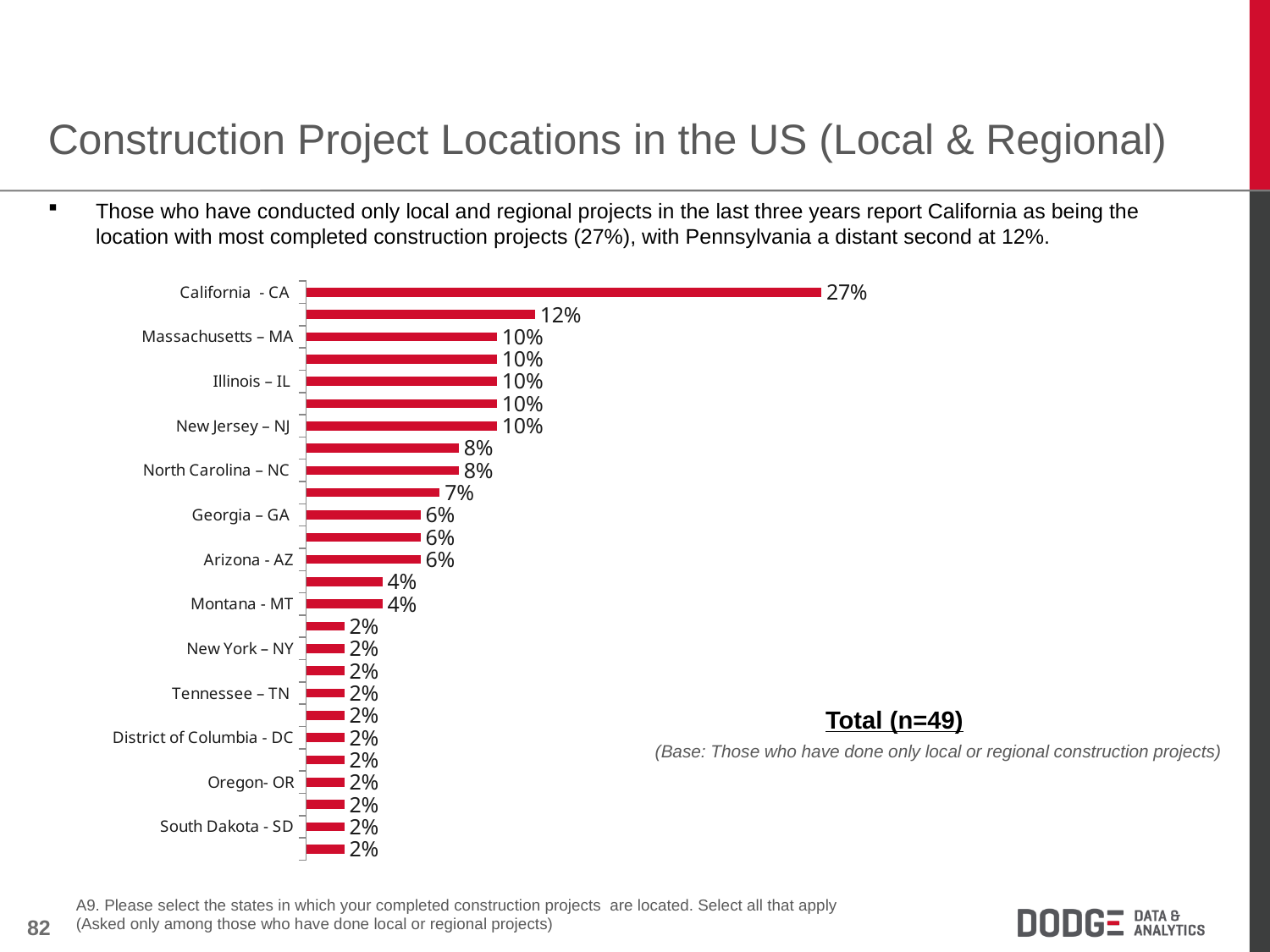
What percentage is shown for North Carolina – NC? 8% What is the difference between the values for California - CA and Massachusetts – MA? 17 percentage points How many bars are plotted in the chart? 26 What percentage is shown for Montana - MT? 4% What value is shown for South Dakota - SD? 2% What value is shown for Georgia – GA? 6% What type of chart is shown on the slide? Bar chart Which state has the highest percentage of completed construction projects in the chart? California - CA What percentage is shown for California - CA? 27% What is the total sample size (n) noted on the slide for this chart? n=49 What value is shown for Massachusetts – MA? 10% Which has a higher value, North Carolina – NC or Arizona - AZ? North Carolina – NC